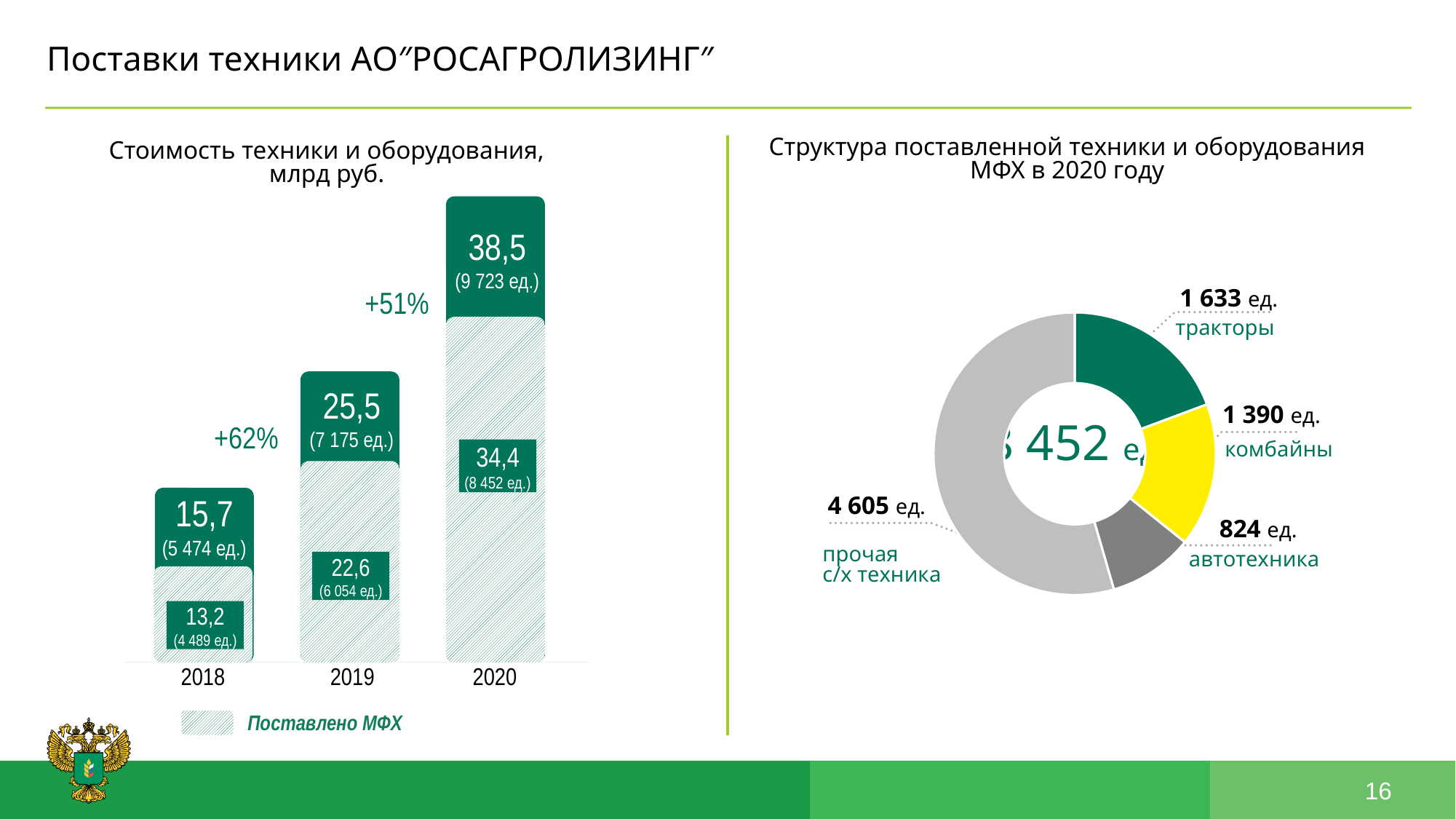
What kind of chart is the left chart 'Стоимость техники и оборудования, млрд руб.'? bar chart On the left chart 'Стоимость техники и оборудования, млрд руб.', which year has the lowest total value? 2018 On the left chart 'Стоимость техники и оборудования, млрд руб.', which year has the highest total value? 2020 On the left chart 'Стоимость техники и оборудования, млрд руб.', do the total values rise or fall from 2018 to 2020? rise On the left chart 'Стоимость техники и оборудования, млрд руб.', what percentage growth is shown between 2018 and 2019? +62% On the left chart 'Стоимость техники и оборудования, млрд руб.', what is the total value for 2020? 38,5 On the right chart 'Структура поставленной техники и оборудования МФХ в 2020 году', which is larger: тракторы or автотехника? тракторы On the right chart 'Структура поставленной техники и оборудования МФХ в 2020 году', which category has the largest number of units? прочая с/х техника On the left chart 'Стоимость техники и оборудования, млрд руб.', what is the value labelled 'Поставлено МФХ' for 2019? 22,6 On the left chart 'Стоимость техники и оборудования, млрд руб.', what is the difference between the total values for 2020 and 2019? 13,0 On the left chart 'Стоимость техники и оборудования, млрд руб.', how many units (ед.) are shown in parentheses for the total in 2018? 5 474 ед. On the right chart 'Структура поставленной техники и оборудования МФХ в 2020 году', how many units are shown for комбайны? 1 390 ед.